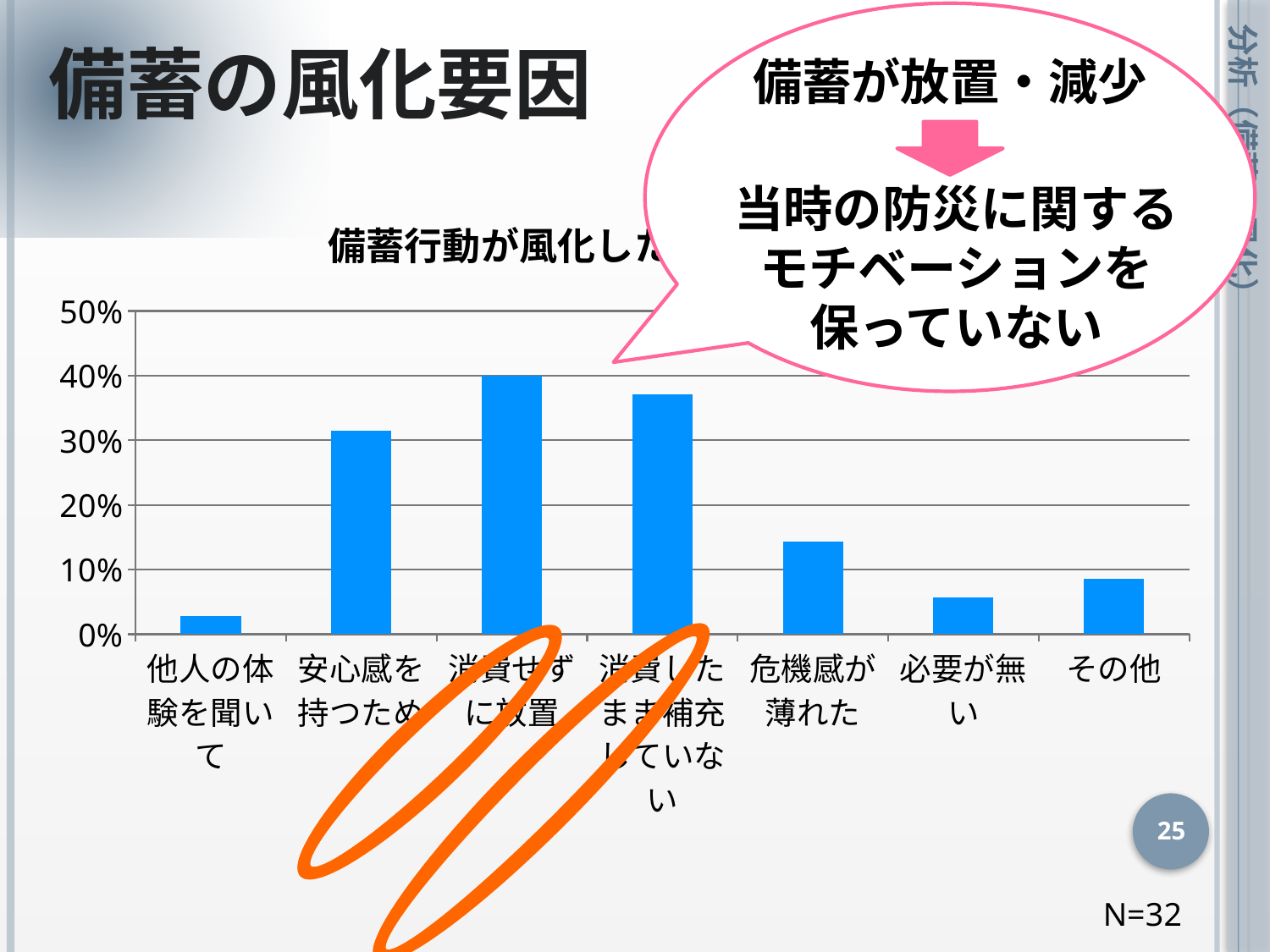
Which is larger, the value for その他 or the value for 必要が無い? その他 What kind of chart is shown on the slide? bar chart Which category has the highest value in the chart? 消費せずに放置 Is the value for 危機感が薄れた greater or less than 20%? less Is the value for 安心感を持つため greater or less than 20%? greater What sample size (N) is stated on the slide for the chart? N=32 What is the highest value shown on the chart's vertical axis? 50% Is the value for 消費したまま補充していない greater or less than 30%? greater Which category has the lowest value in the chart? 他人の体験を聞いて Which is larger, the value for 安心感を持つため or the value for 危機感が薄れた? 安心感を持つため How many categories are shown on the x axis of the chart? 7